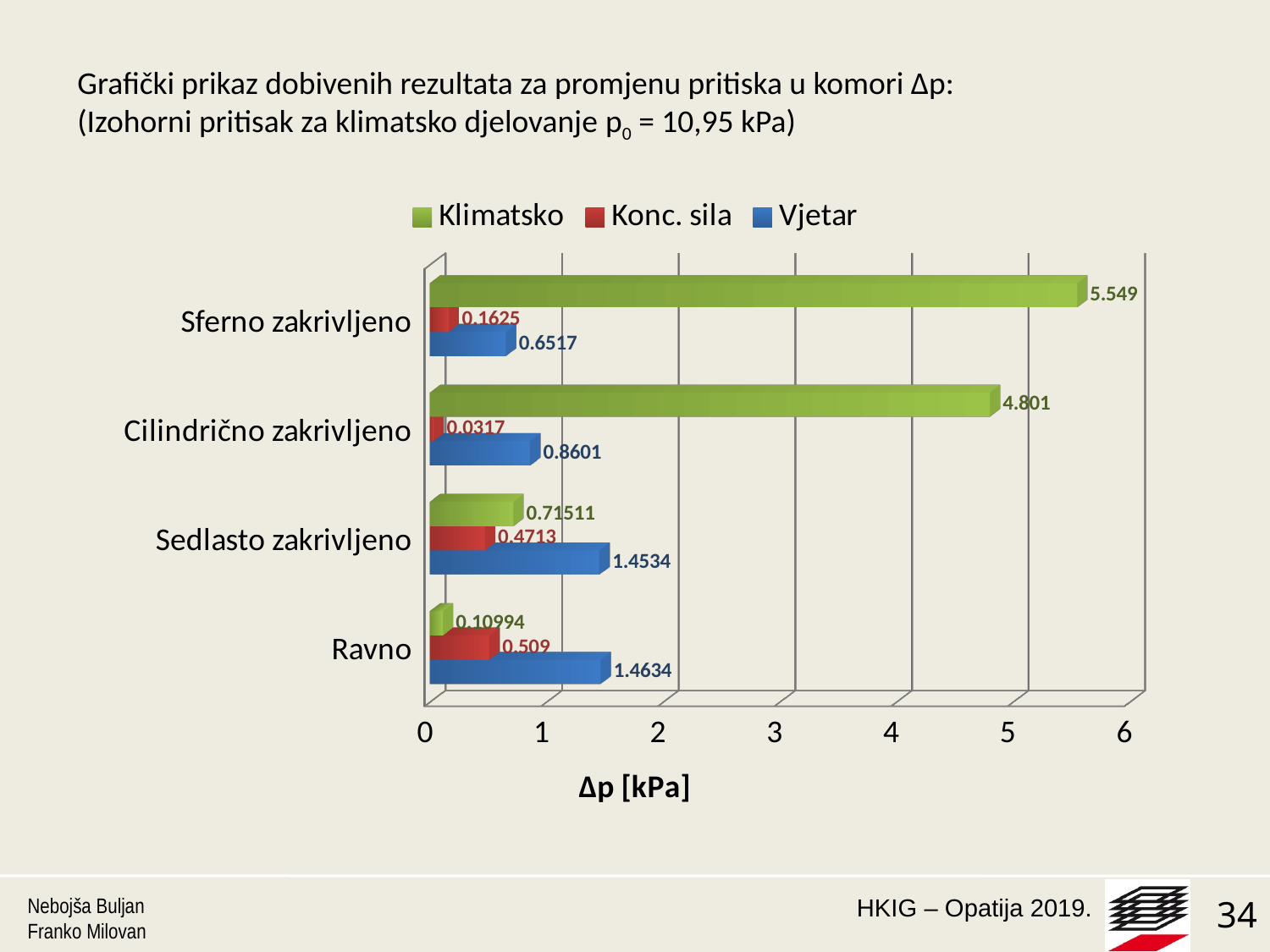
What is the Klimatsko value for Sedlasto zakrivljeno? 0.71511 Which category has the lowest Vjetar value? Sferno zakrivljeno Which category has the lowest Konc. sila value? Cilindrično zakrivljeno What kind of chart is shown on the slide? Bar chart What is the Vjetar value for Cilindrično zakrivljeno? 0.8601 How many categories are shown on the chart? 4 What is the Konc. sila value for Ravno? 0.509 For Sedlasto zakrivljeno, which is larger: the Vjetar value or the Konc. sila value? Vjetar What is the Klimatsko value for Sferno zakrivljeno? 5.549 Which category has the highest Klimatsko value? Sferno zakrivljeno What is the difference between the Klimatsko values for Sferno zakrivljeno and Cilindrično zakrivljeno? 0.748 How many series does the legend list? 3